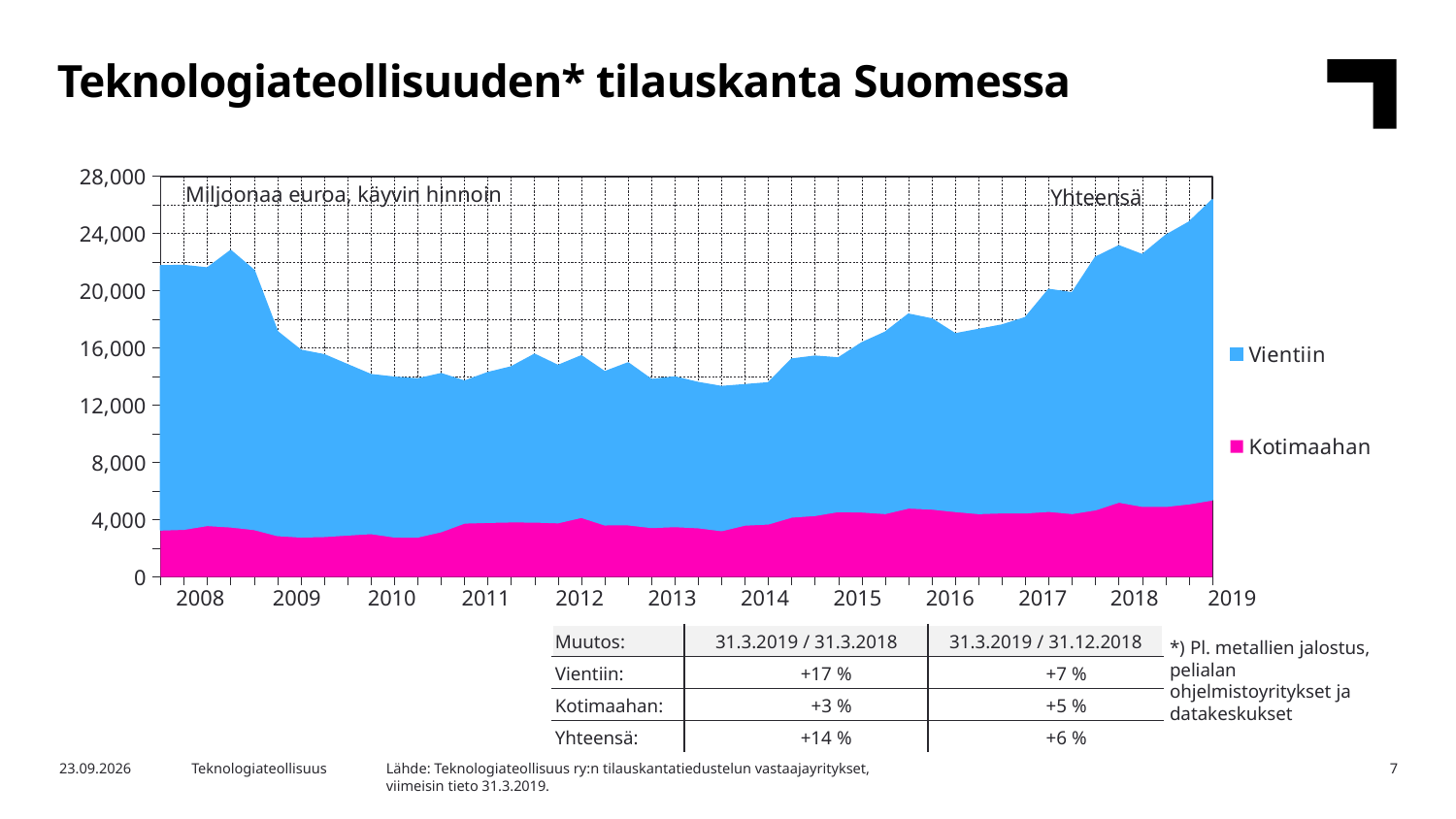
Does the total order backlog rise or fall between 2017 and 2019? rises Is the total order backlog (Yhteensä) around 2013 greater or less than 16,000? less How many series does the chart legend list? 2 Is the total order backlog (Yhteensä) at the 2019 end of the chart greater or less than 24,000? greater How many year labels are shown on the x axis of the chart? 12 Is the Kotimaahan value at the 2019 end of the chart greater or less than 8,000? less What unit label is shown inside the chart area? Miljoonaa euroa, käyvin hinnoin Which series accounts for the larger part of the order backlog throughout the chart, Vientiin or Kotimaahan? Vientiin Which two series are listed in the chart legend? Vientiin and Kotimaahan Does the total order backlog rise or fall between late 2008 and 2010? falls What kind of chart is shown on the slide? Area chart